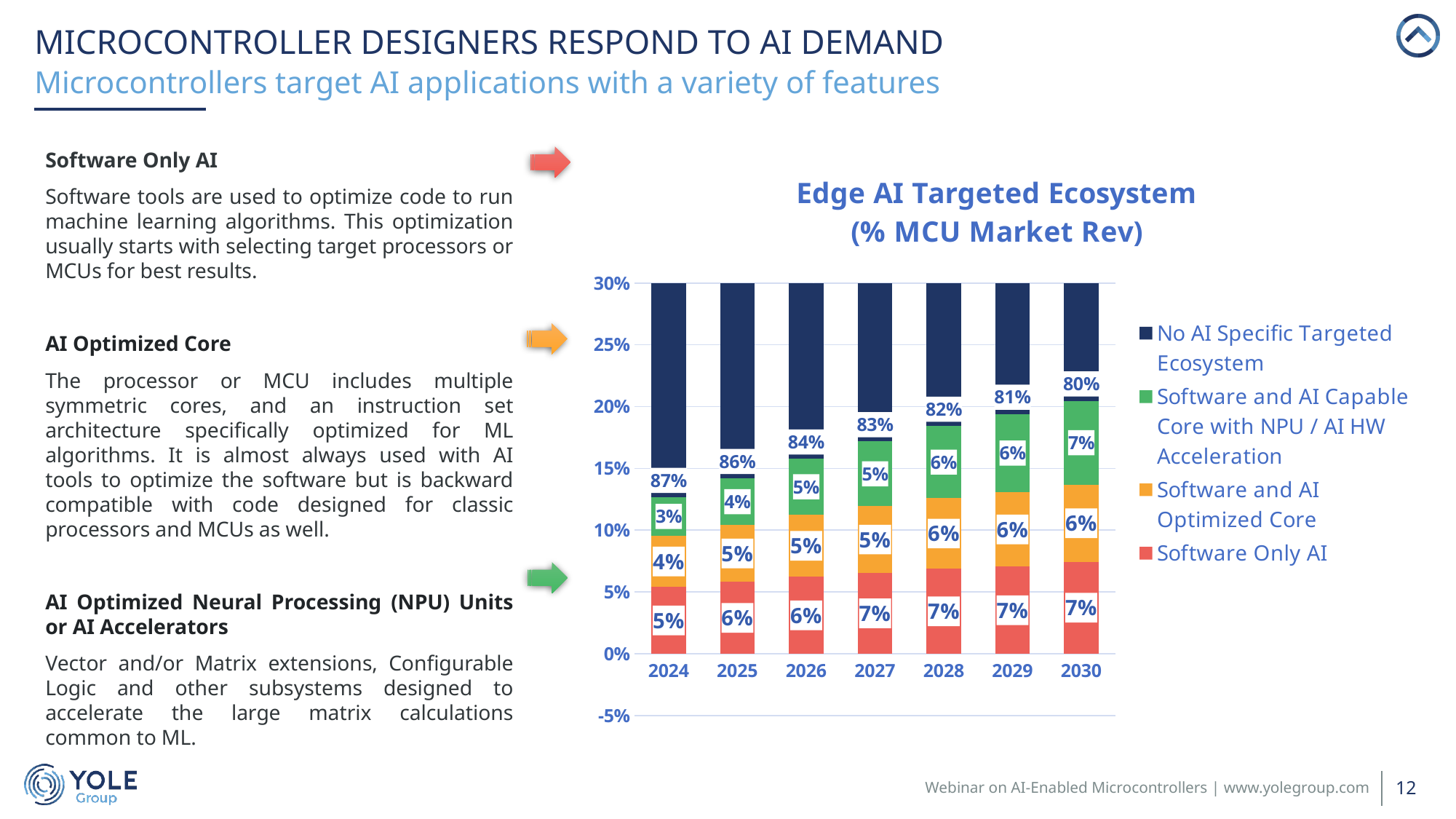
What is the value for Software Only AI in 2024? 5% Does the Software and AI Capable Core with NPU / AI HW Acceleration share rise or fall from 2024 to 2030? Rise How many years are shown on the x axis? 7 What kind of chart is shown? Stacked bar chart How many series does the legend list? 4 What is the value for No AI Specific Targeted Ecosystem in 2026? 84% What is the difference between the No AI Specific Targeted Ecosystem value in 2024 and in 2030? 7% What is the value for Software and AI Capable Core with NPU / AI HW Acceleration in 2030? 7% In which year is the No AI Specific Targeted Ecosystem share the lowest? 2030 In which year is the No AI Specific Targeted Ecosystem share the highest? 2024 What is the value for Software and AI Optimized Core in 2028? 6% Which is larger in 2025: Software Only AI or Software and AI Capable Core with NPU / AI HW Acceleration? Software Only AI